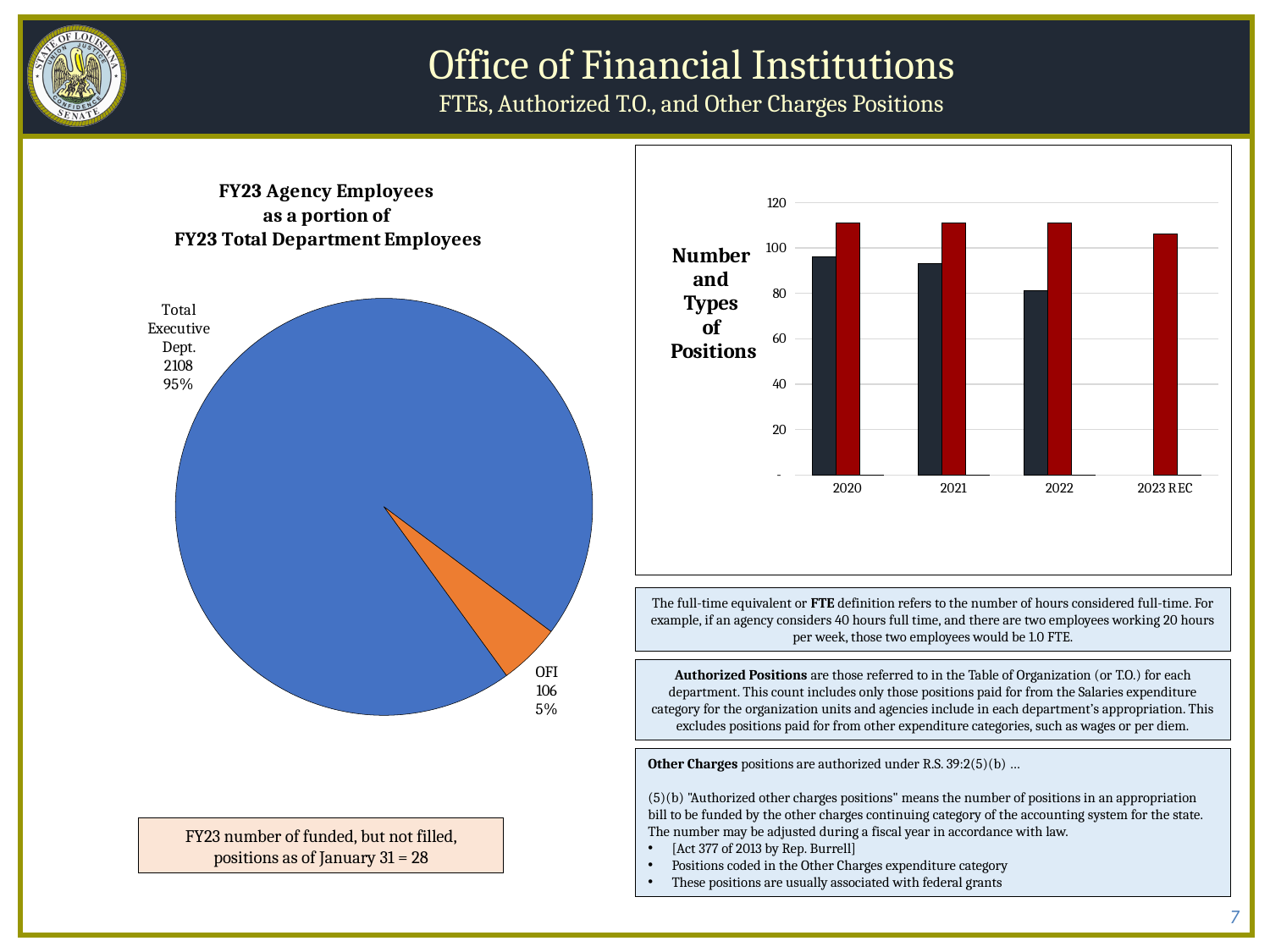
How many year categories are shown on the x axis of the 'Number and Types of Positions' bar chart? 4 In the 'Number and Types of Positions' bar chart, is the dark bar for 2022 greater or less than 100? less What type of chart is the 'Number and Types of Positions' chart on the right? Bar chart How many slices does the pie chart on the left have? 2 What type of chart is the chart on the left of the slide? Pie chart In the pie chart on the left, what percentage share does OFI represent? 5% In the 'Number and Types of Positions' bar chart, do the dark bars rise or fall from 2020 to 2022? fall In the pie chart titled 'FY23 Agency Employees as a portion of FY23 Total Department Employees', what is the value shown for OFI? 106 In the pie chart on the left, which slice is larger, OFI or Total Executive Dept.? Total Executive Dept. In the pie chart on the left, what percentage share does Total Executive Dept. represent? 95% In the 'Number and Types of Positions' bar chart, is the red bar for 2020 greater or less than 100? greater In the pie chart on the left, what is the value shown for Total Executive Dept.? 2108